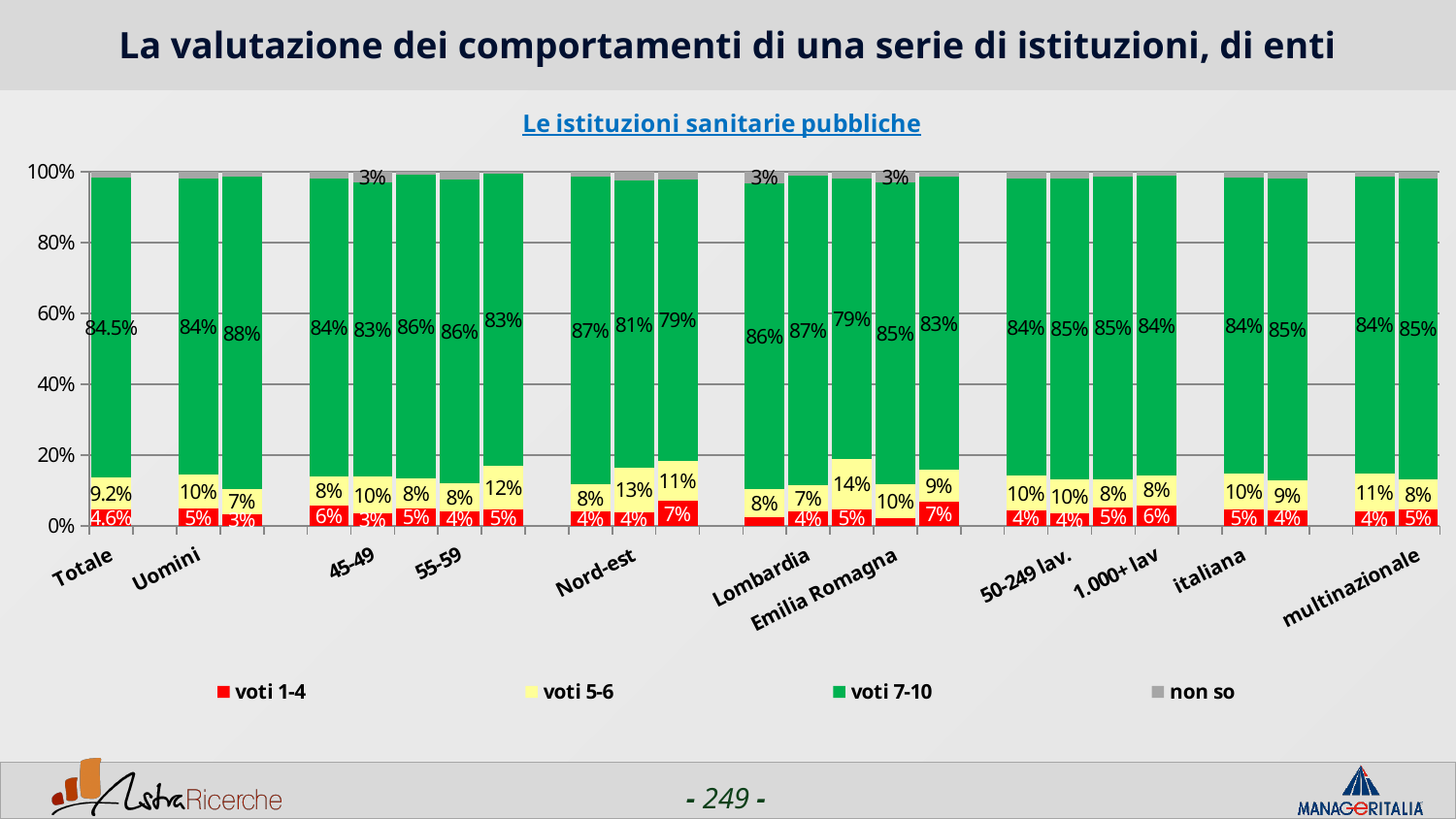
What is the title of the chart? Le istituzioni sanitarie pubbliche What is the value of 'voti 5-6' for 'Nord-est'? 13% How many series does the legend list? 4 What is the value of 'voti 7-10' for the 'Totale' bar? 84.5% What is the value of 'voti 5-6' for the 'Totale' bar? 9.2% What is the value of 'voti 1-4' for the 'Totale' bar? 4.6% Which colour represents 'voti 7-10' in the legend? Green Is the 'voti 7-10' value for 'Totale' greater or less than 80%? greater What kind of chart is shown on the slide? Stacked bar chart What is the value of 'voti 7-10' for 'Nord-est'? 81% What is the value of 'voti 7-10' for 'Uomini'? 84% What is the value of 'voti 5-6' for 'Uomini'? 10%